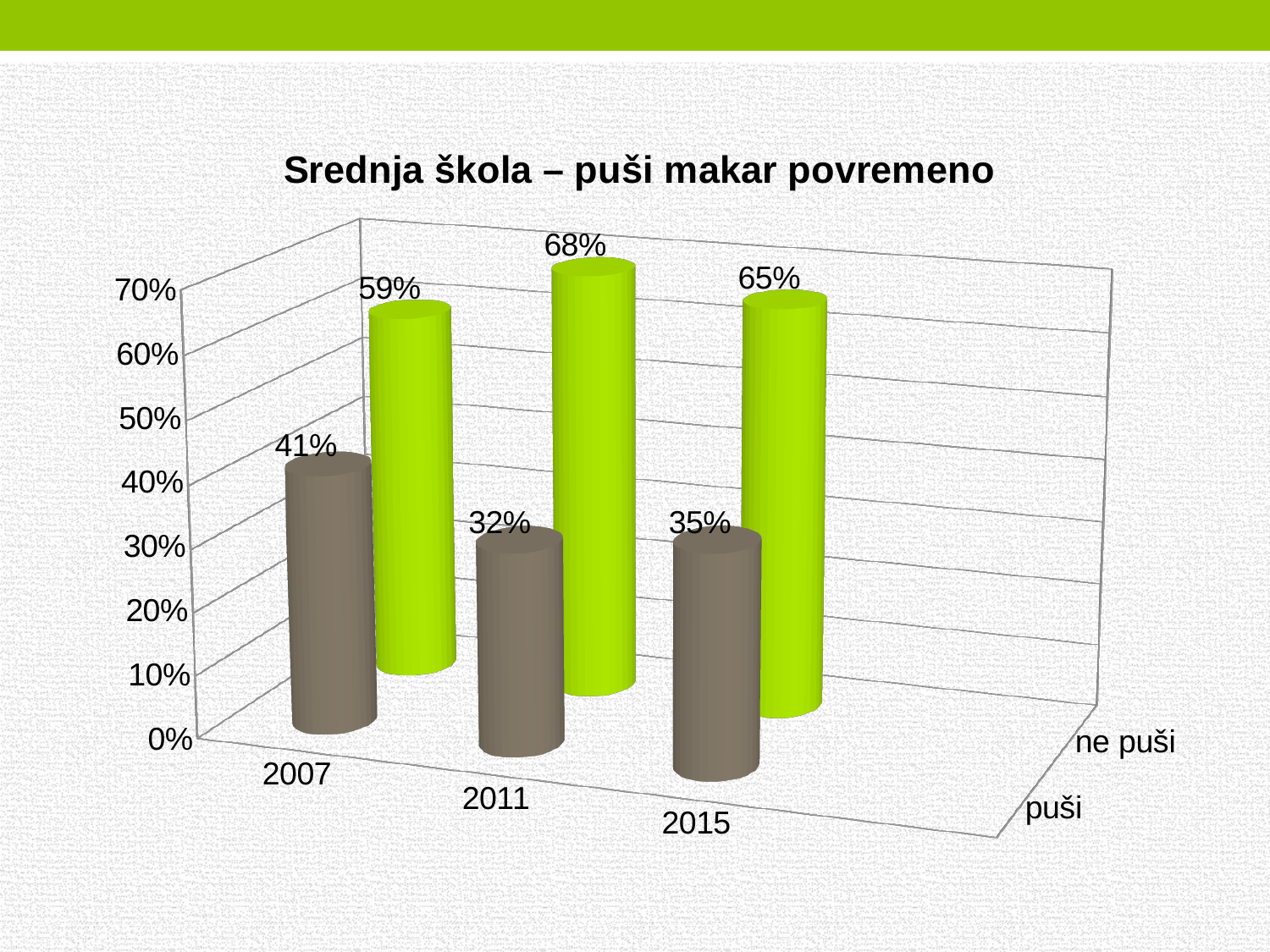
What is the value for "ne puši" in 2015? 65% What kind of chart is this? bar chart What is the title of the chart? Srednja škola – puši makar povremeno What is the difference between the "ne puši" and "puši" values in 2007? 18% How many series does the chart show? 2 What is the value for "ne puši" in 2011? 68% What is the value for "puši" in 2015? 35% In which year is the "ne puši" value highest? 2011 Which is larger in 2015: the "puši" value or the "ne puši" value? ne puši How many years are shown on the x axis? 3 What is the value for "puši" in 2007? 41% In which year is the "puši" value lowest? 2011